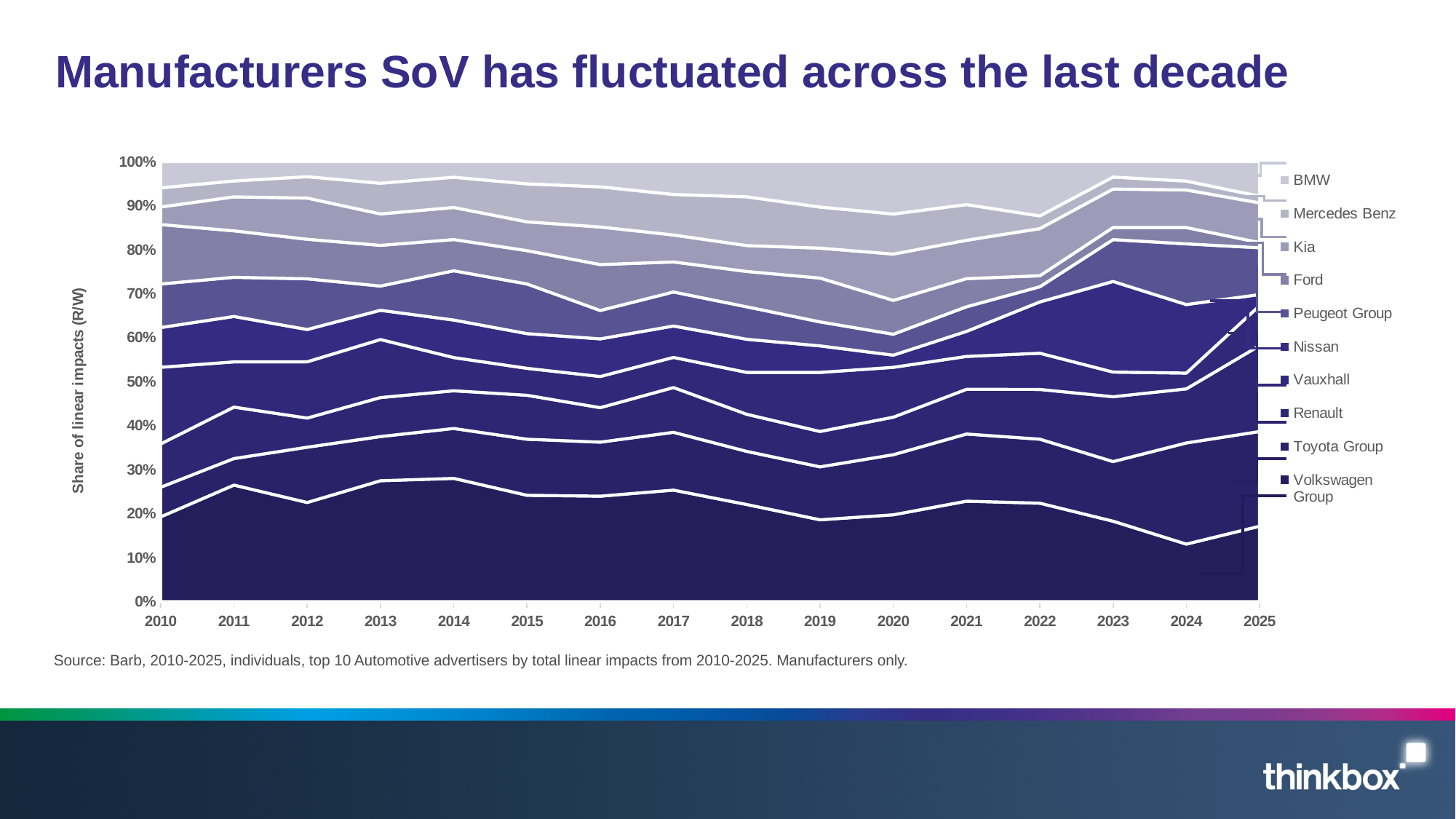
What is the label on the y axis? Share of linear impacts (R/W) Is the share for Volkswagen Group in 2024 greater or less than 20%? less Is the share for Volkswagen Group in 2021 greater or less than 20%? greater Which manufacturer is the bottom layer of the stacked area chart? Volkswagen Group Does the Volkswagen Group share rise or fall from 2021 to 2024? Fall In which year is the Volkswagen Group share at its lowest? 2024 How many years are shown along the x axis? 16 Is the Volkswagen Group share larger in 2014 or in 2024? 2014 Is the share for Volkswagen Group in 2013 greater or less than 30%? less What kind of chart is shown on the slide? Stacked area chart How many manufacturers does the legend list? 10